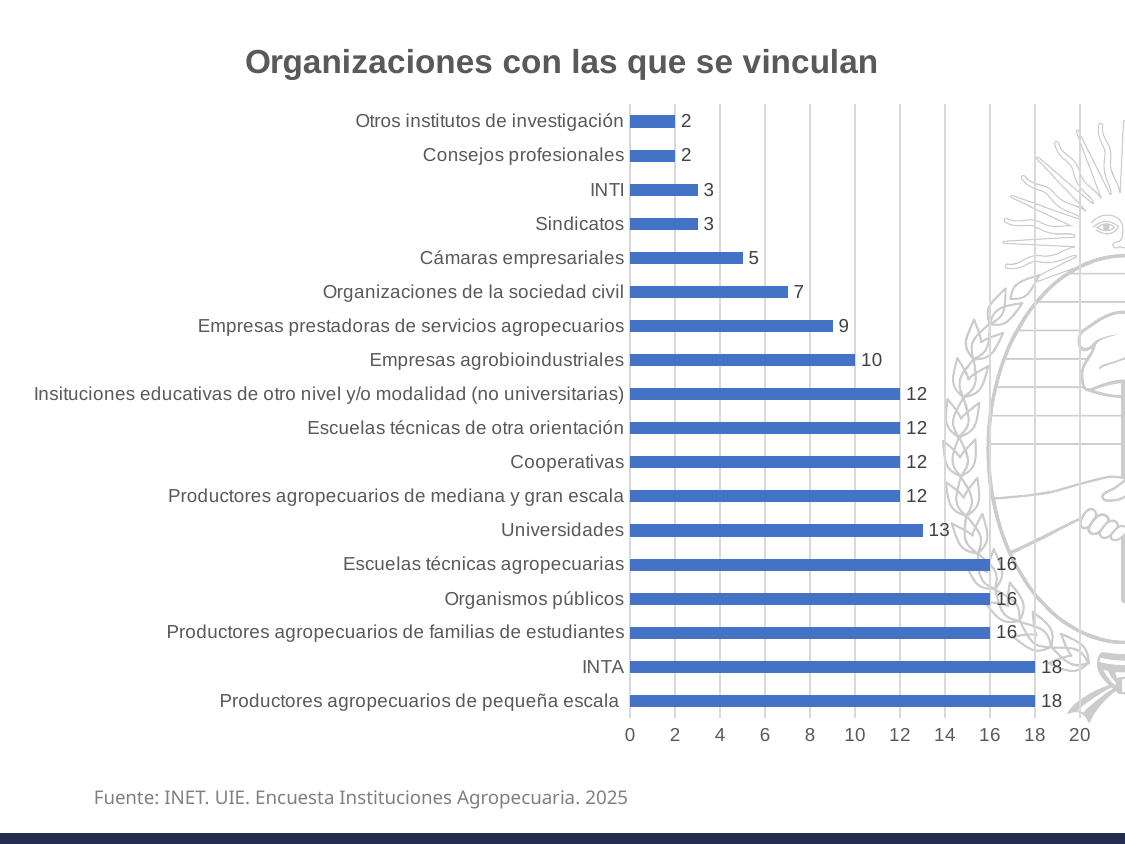
What is the difference between the values for Organismos públicos and Cooperativas? 4 What is the difference between the values for INTA and INTI? 15 What is the value for Organizaciones de la sociedad civil? 7 Which is larger, the value for Empresas prestadoras de servicios agropecuarios or the value for Escuelas técnicas agropecuarias? Escuelas técnicas agropecuarias What kind of chart is shown on the slide? Bar chart What is the value for Cámaras empresariales? 5 What is the value for Universidades? 13 What is the value for Empresas agrobioindustriales? 10 What is the title of the chart? Organizaciones con las que se vinculan Which is larger, the value for Universidades or the value for Sindicatos? Universidades What is the value for INTA? 18 How many categories are shown in the chart? 18